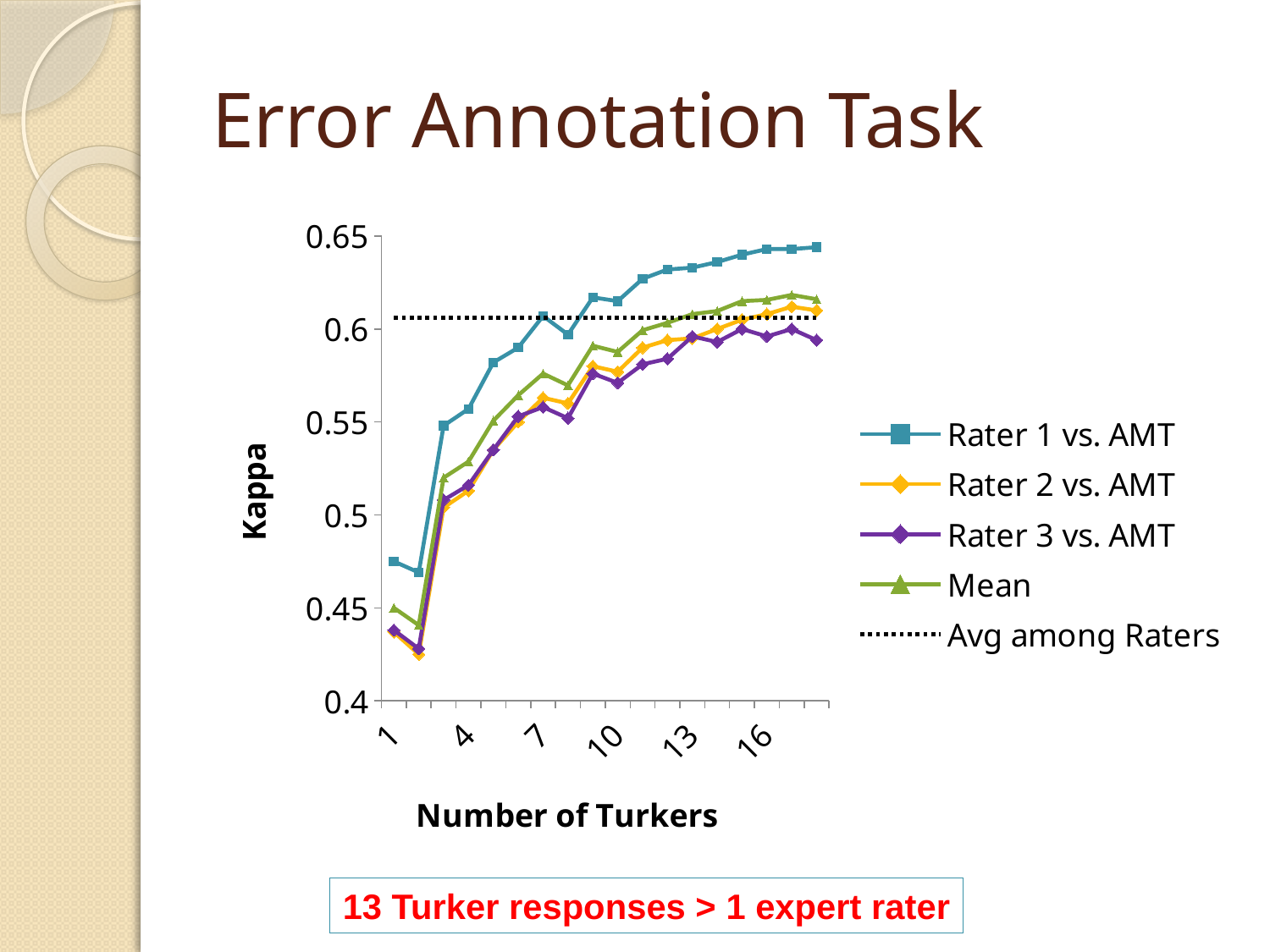
What is the title of the x axis? Number of Turkers Is the value for Rater 3 vs. AMT at 1 Turker greater or less than 0.45? less Which series has the highest Kappa at 16 Turkers? Rater 1 vs. AMT Which series has the lowest Kappa at 16 Turkers? Rater 3 vs. AMT What is the title of the y axis? Kappa What kind of chart is shown on the slide? line chart Is the value for Rater 1 vs. AMT at 1 Turker greater or less than 0.45? greater Is the value for Rater 1 vs. AMT at 16 Turkers greater or less than 0.6? greater Does the Kappa for Rater 1 vs. AMT generally rise or fall as the number of Turkers increases? rise At 16 Turkers, which is larger: Rater 1 vs. AMT or Rater 3 vs. AMT? Rater 1 vs. AMT How many series does the legend list? 5